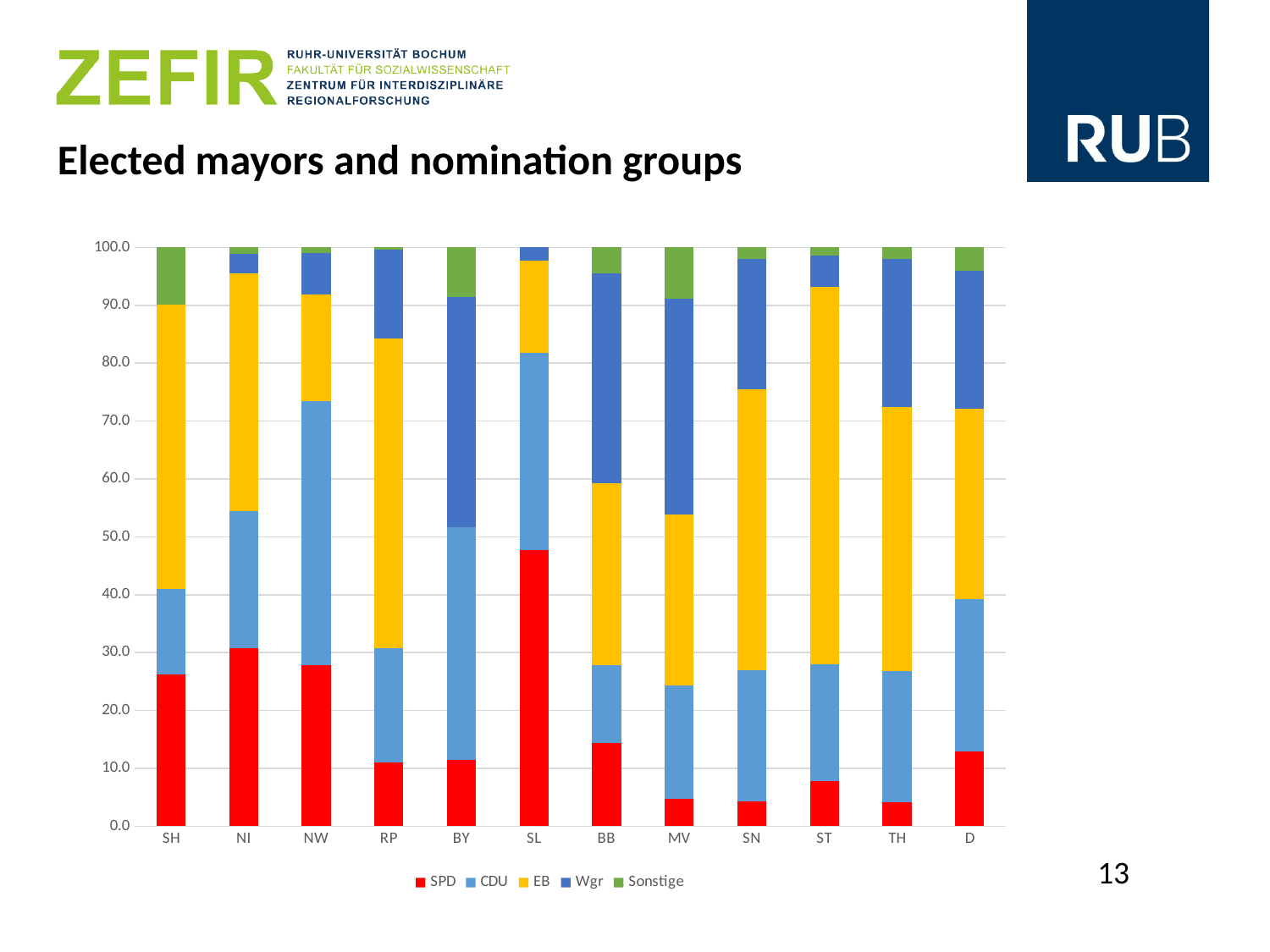
What is the title of the chart slide? Elected mayors and nomination groups What kind of chart is shown on the slide? stacked bar chart Which category has the largest SPD segment? SL Is the SPD value for SH greater or less than 20? greater Which has the larger Sonstige segment, SH or NI? SH Is the SPD value for SL greater or less than 40? greater Which colour represents SPD in the chart? red How many categories are shown on the x axis of the chart? 12 Is the SPD value for RP greater or less than 20? less Which category has the largest EB segment? ST Which has the larger SPD segment, SL or NI? SL How many series does the legend list? 5